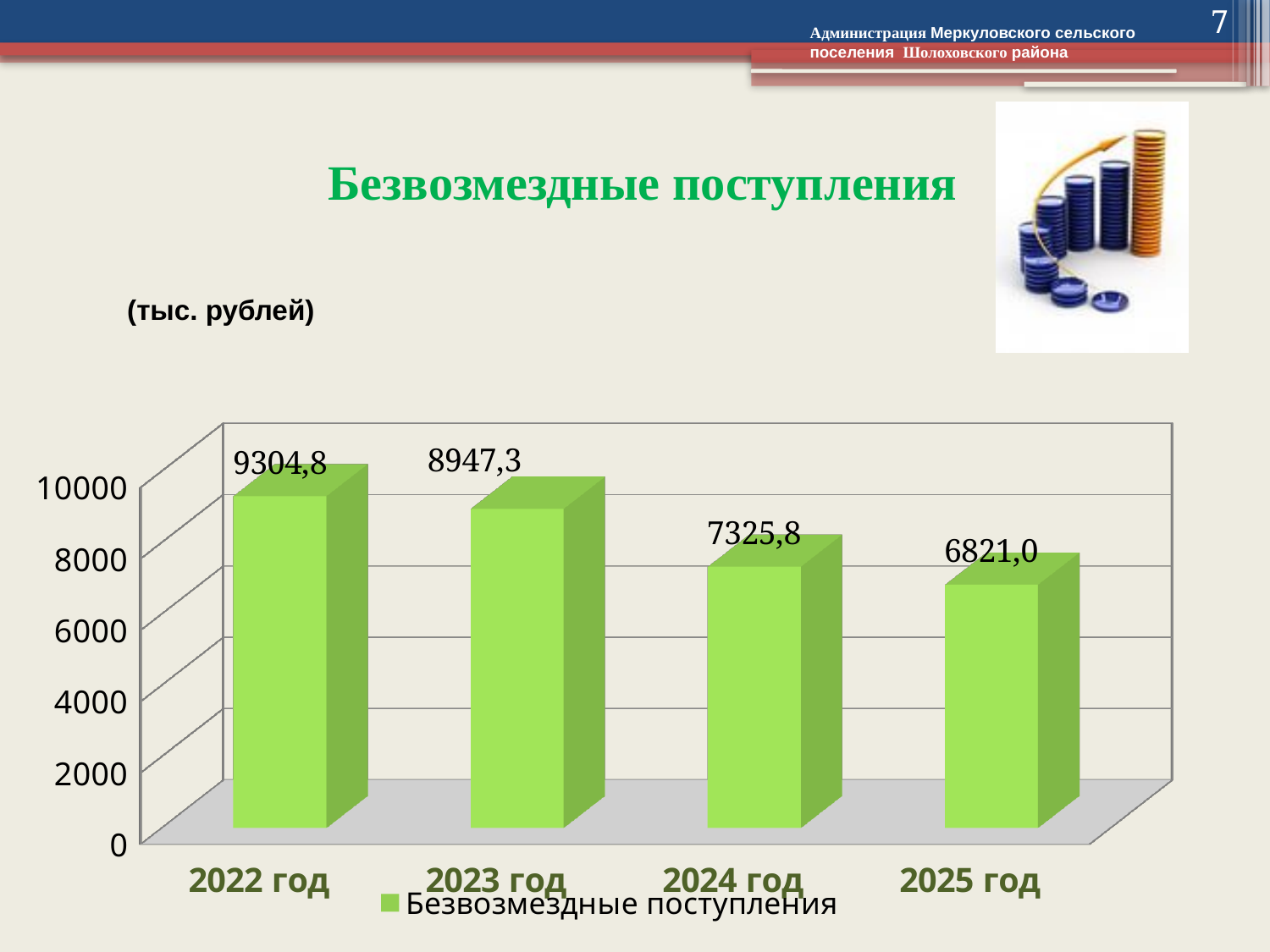
What is the value for 2025 год? 6821,0 What is the value for 2022 год? 9304,8 Which year has the highest value? 2022 год Do the values rise or fall from 2022 год to 2025 год? fall What is the difference between the values for 2023 год and 2024 год? 1621,5 What is the value for 2024 год? 7325,8 What kind of chart is shown on the slide? bar chart Is the value for 2023 год greater or less than 8000? greater What is the difference between the values for 2022 год and 2023 год? 357,5 Which year has the lowest value? 2025 год How many years are shown on the chart? 4 Which is larger, the value for 2024 год or the value for 2025 год? 2024 год